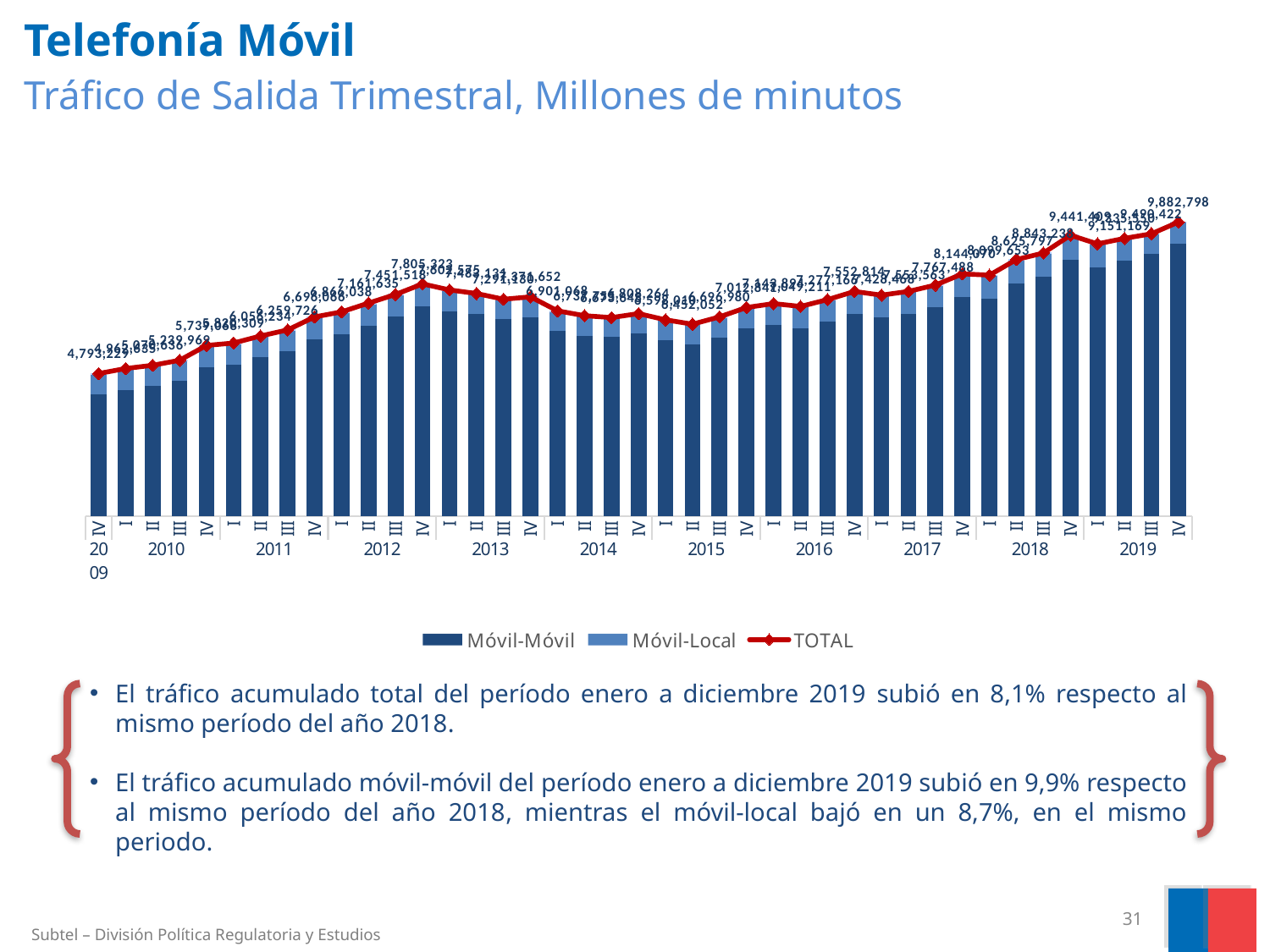
What kind of chart is shown on the slide? bar chart (stacked) with a line In IV 2019, which segment is larger, Móvil-Móvil or Móvil-Local? Móvil-Móvil What is the TOTAL value for IV 2019? 9,882,798 Overall, does the TOTAL line rise or fall from IV 2009 to IV 2019? rise What is the difference between the TOTAL for IV 2019 and the TOTAL for IV 2009? 5,089,569 Which quarter has the lowest TOTAL value? IV 2009 Which is larger, the TOTAL for IV 2012 or the TOTAL for IV 2019? IV 2019 How many series does the legend list? 3 What is the TOTAL value for IV 2009? 4,793,229 What are the three legend entries? Móvil-Móvil, Móvil-Local, TOTAL What is the TOTAL value for IV 2012? 7,805,323 Which quarter has the highest TOTAL value? IV 2019